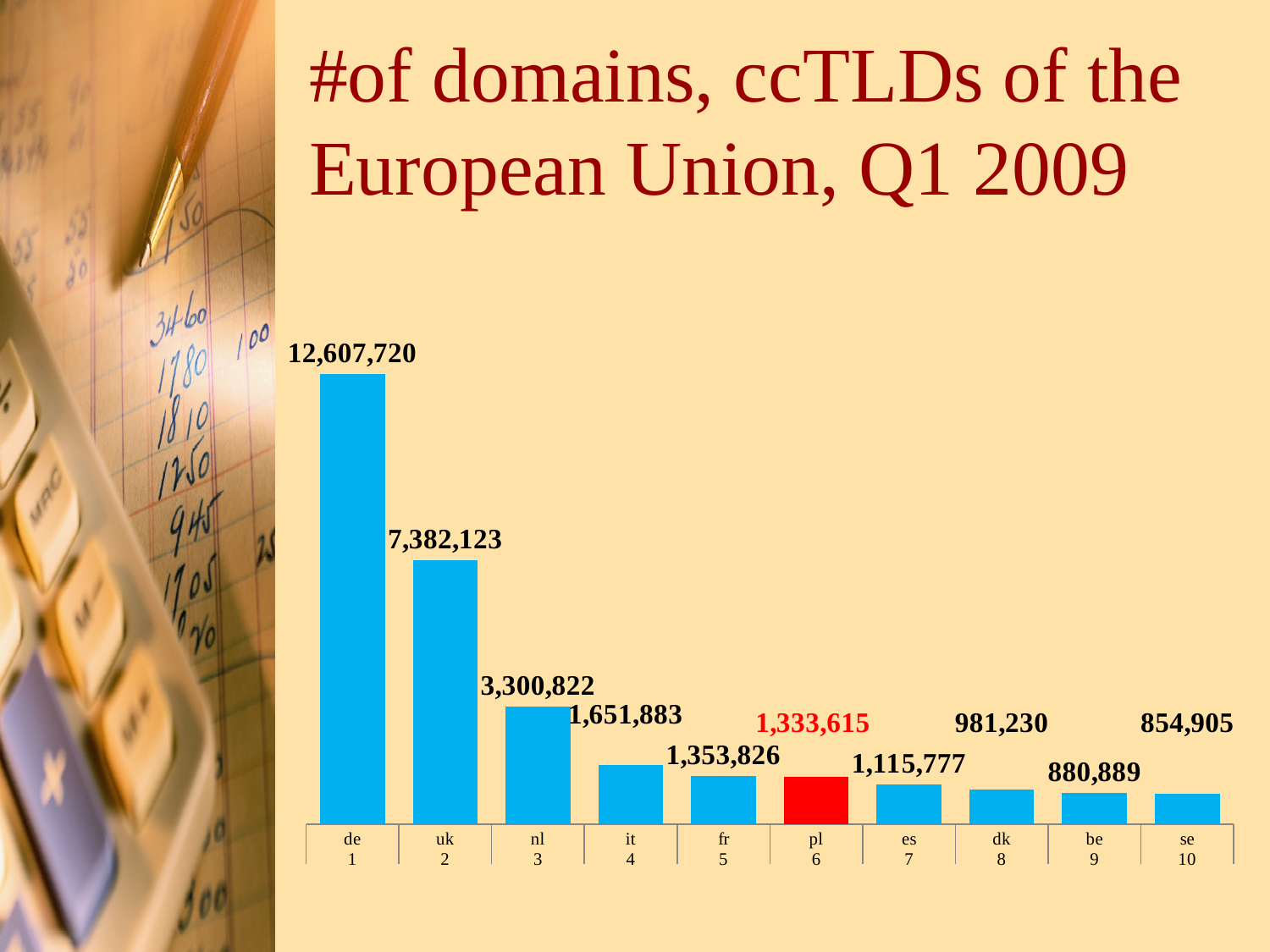
What is the number of domains for pl? 1,333,615 Do the values rise or fall moving from left to right along the x axis? fall What is the number of domains for se? 854,905 What is the difference in number of domains between dk and be? 100,341 What is the number of domains for de? 12,607,720 Which ccTLD's bar is coloured red instead of blue? pl Which has more domains, es or dk? es What is the difference in number of domains between de and uk? 5,225,597 Which ccTLD has the highest number of domains? de Which ccTLD has the lowest number of domains? se How many ccTLDs are shown in the chart? 10 What type of chart is shown on the slide? bar chart